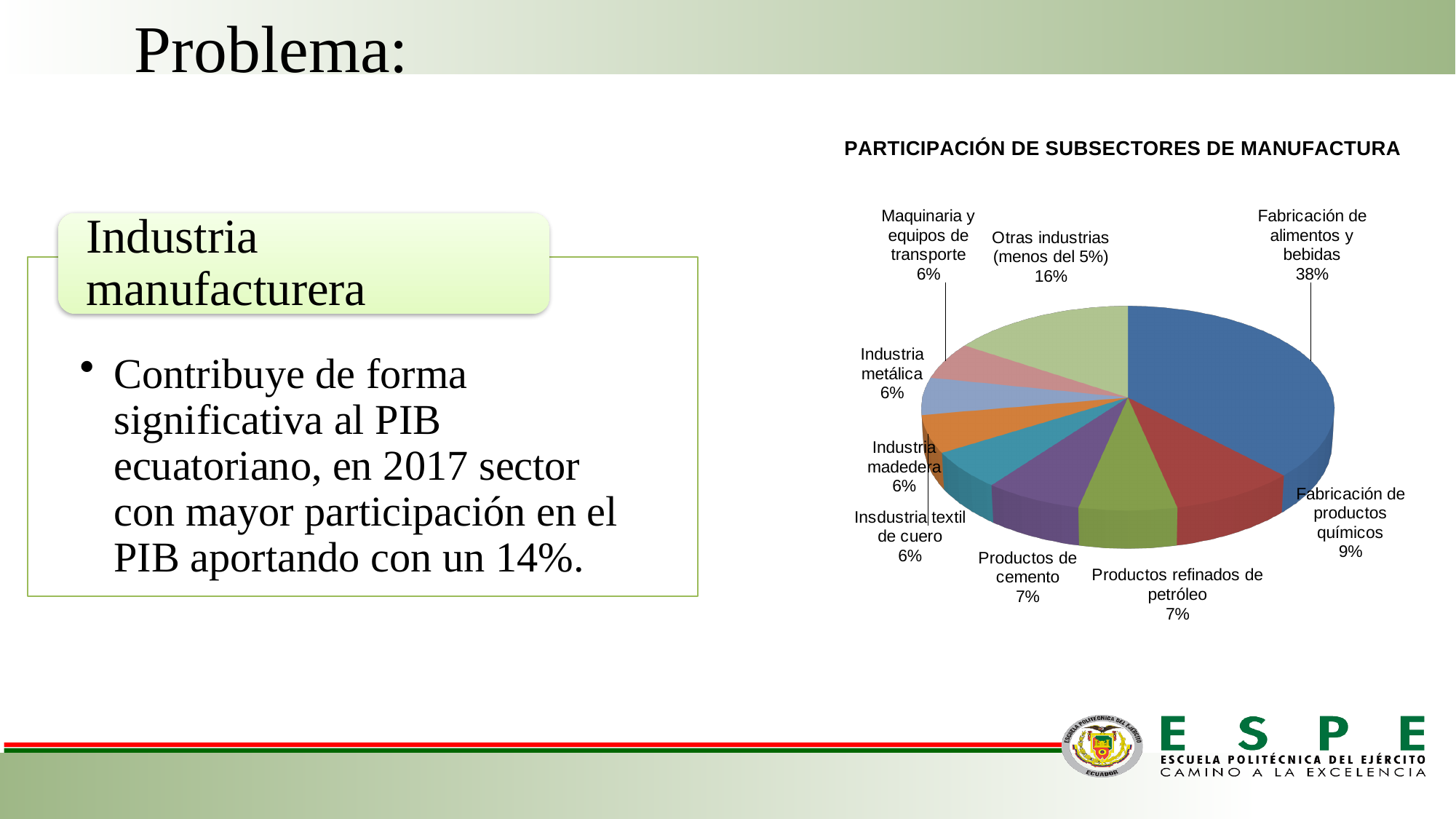
What is the value shown for Fabricación de productos químicos? 9% What is the value shown for Productos refinados de petróleo? 7% What is the value shown for Industria metálica? 6% How many slices does the pie chart have? 9 What kind of chart is shown on the slide? Pie chart Which is larger, the share for Fabricación de productos químicos or the share for Productos de cemento? Fabricación de productos químicos What is the title of the chart? PARTICIPACIÓN DE SUBSECTORES DE MANUFACTURA What share of the pie does Otras industrias (menos del 5%) have? 16% Which subsector has the largest share of the pie? Fabricación de alimentos y bebidas What share of the pie does Fabricación de alimentos y bebidas have? 38% What is the difference in percentage points between Fabricación de alimentos y bebidas and Otras industrias (menos del 5%)? 22 What is the difference in percentage points between Fabricación de productos químicos and Maquinaria y equipos de transporte? 3